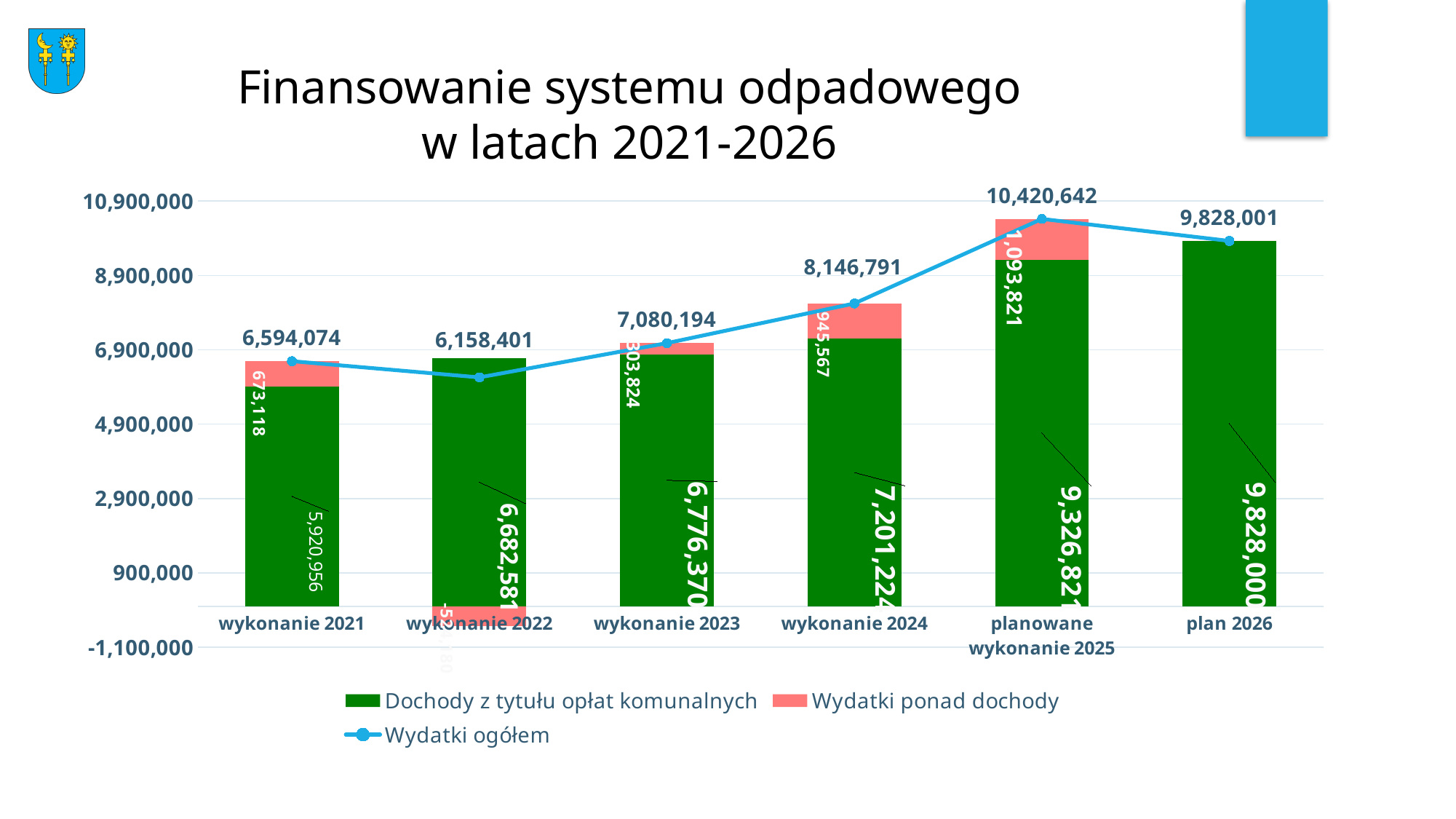
Between wykonanie 2022 and planowane wykonanie 2025, does Wydatki ogółem rise or fall? rise How many categories are shown on the x axis? 6 What is the value of Wydatki ogółem for wykonanie 2024? 8,146,791 Which category has the lowest value of Wydatki ogółem? wykonanie 2022 What kind of chart is shown on the slide? A bar chart combined with a line What is the difference in Wydatki ogółem between planowane wykonanie 2025 and plan 2026? 592,641 Is the value of Dochody z tytułu opłat komunalnych for plan 2026 greater or less than 8,900,000? greater Which category has the highest value of Wydatki ogółem? planowane wykonanie 2025 What is the value of Wydatki ponad dochody for planowane wykonanie 2025? 1,093,821 Which is larger, Wydatki ogółem for wykonanie 2023 or for wykonanie 2024? wykonanie 2024 How many series does the legend list? 3 What is the value of Dochody z tytułu opłat komunalnych for wykonanie 2023? 6,776,370